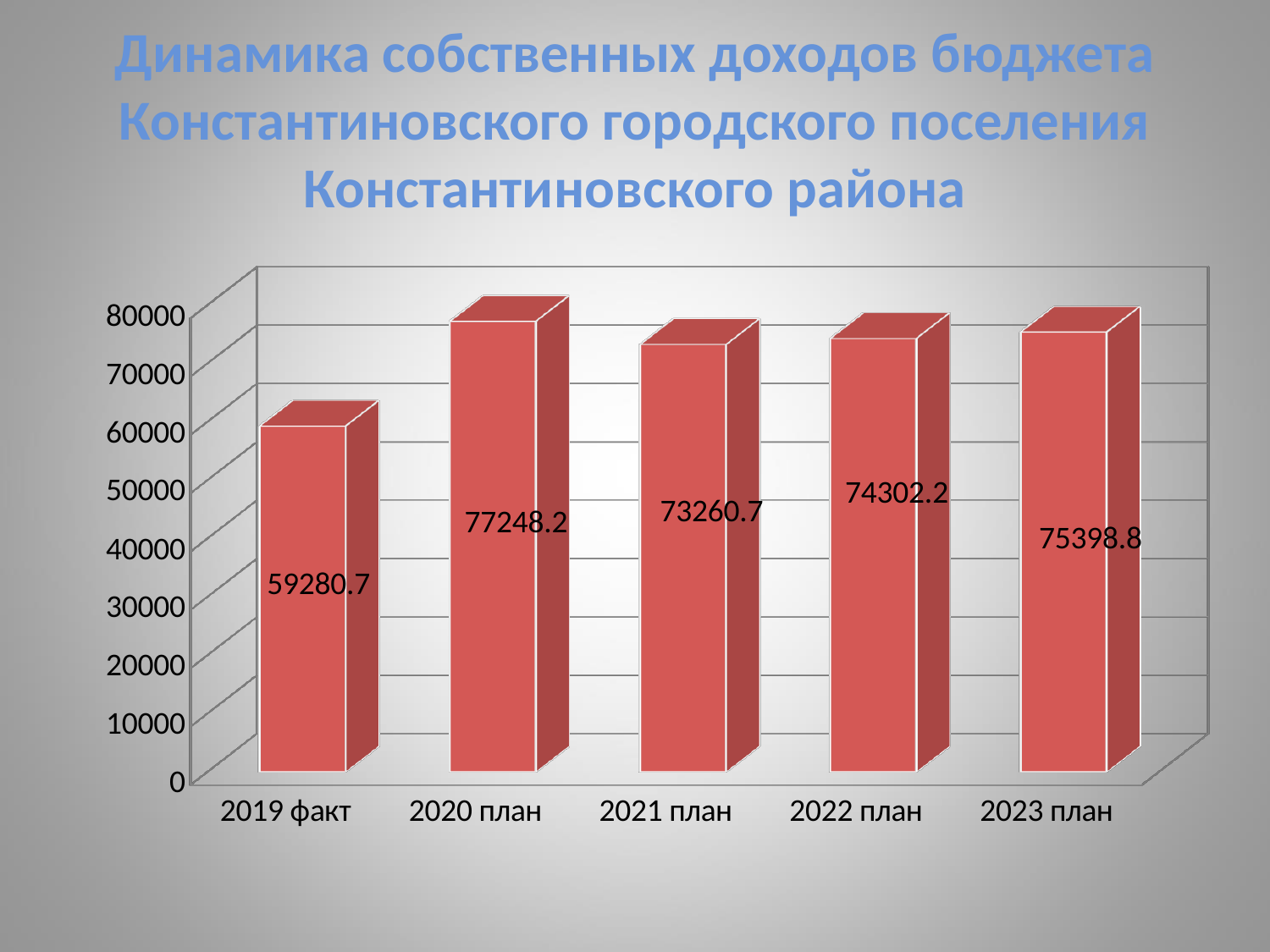
What is the difference between the values for 2023 план and 2021 план? 2138.1 What colour are the bars in the chart? red Which category has the lowest value? 2019 факт How many categories are shown on the x axis? 5 What is the value for 2023 план? 75398.8 What is the difference between the values for 2020 план and 2019 факт? 17967.5 What is the value for 2021 план? 73260.7 What is the value for 2019 факт? 59280.7 What kind of chart is shown on the slide? bar chart Is the value for 2019 факт greater or less than 60000? less Which category has the highest value? 2020 план Which is larger, the value for 2022 план or the value for 2021 план? 2022 план